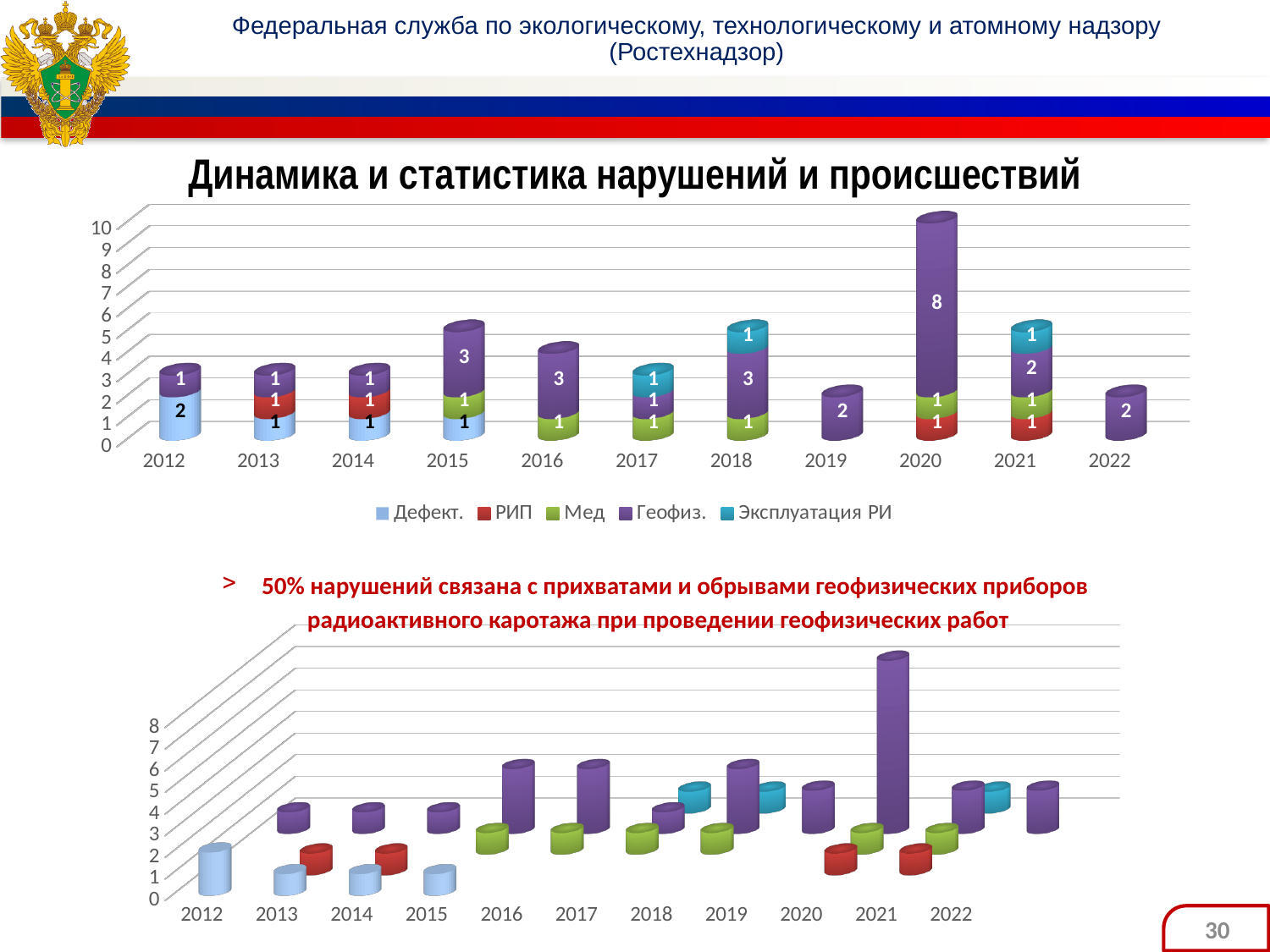
In the top chart, what is the value of the Геофиз. segment for 2020? 8 In the top chart, what is the total of the stacked bar for 2015? 5 In the top chart, what is the difference between the Геофиз. value for 2020 and the Геофиз. value for 2019? 6 In the top chart, which is larger: the Геофиз. value for 2016 or the Геофиз. value for 2022? 2016 In the top chart, which year has the tallest stacked bar? 2020 What kind of chart is the top chart? Stacked bar chart How many years are shown on the x axis of the top chart? 11 How many series does the legend of the top chart list? 5 In the top chart, what is the value of the Дефект. segment for 2012? 2 In the top chart, what is the value of the Эксплуатация РИ segment for 2018? 1 In the top chart, what is the total of the stacked bar for 2021? 5